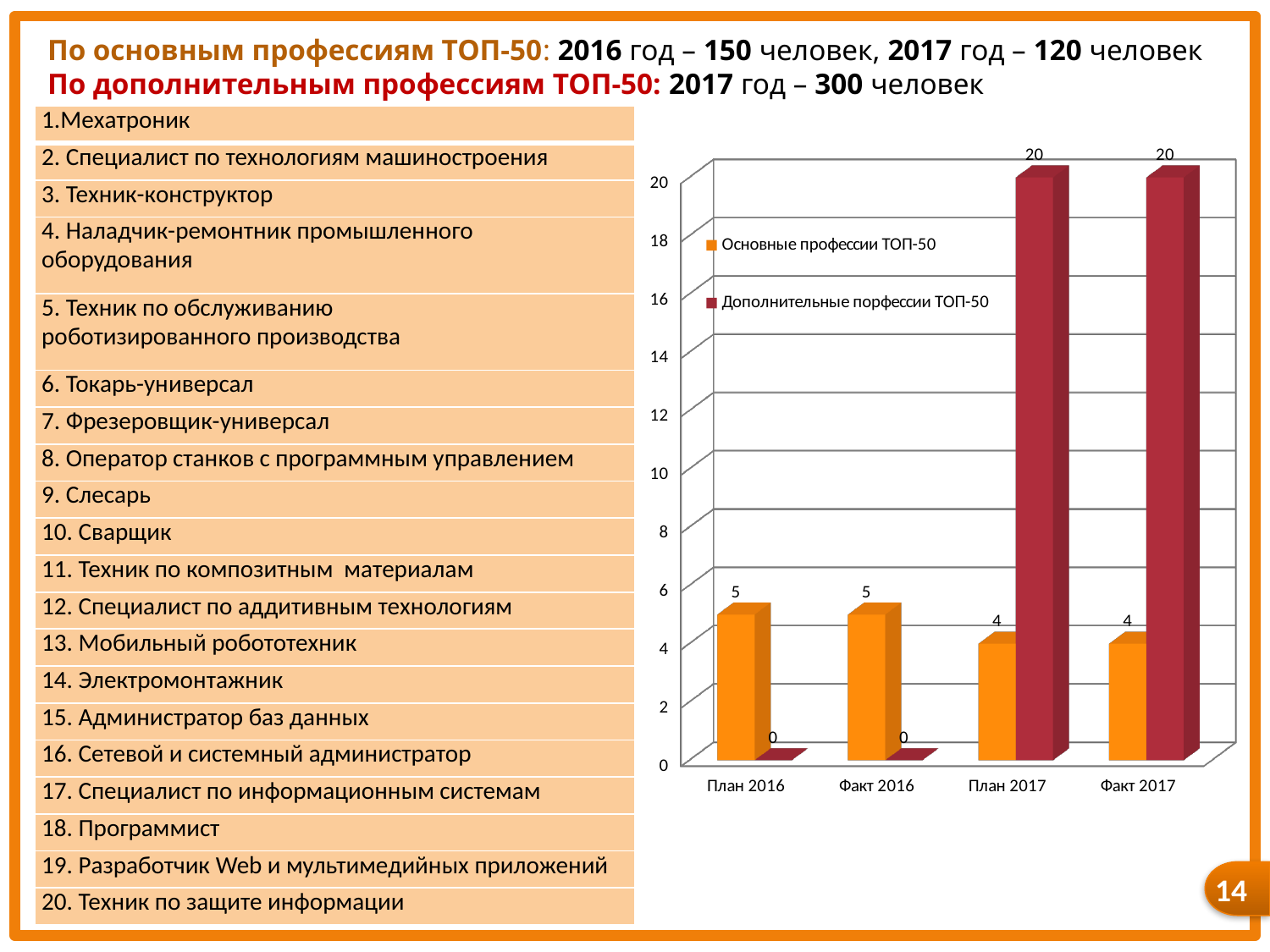
How many series does the chart legend list? 2 What is the difference between Дополнительные порфессии ТОП-50 and Основные профессии ТОП-50 for План 2017? 16 Which series has the larger value for Факт 2016? Основные профессии ТОП-50 Does the value of Основные профессии ТОП-50 fall or rise from Факт 2016 to План 2017? fall How many categories are shown on the x axis of the chart? 4 What is the value of Дополнительные порфессии ТОП-50 for Факт 2016? 0 What is the value of Основные профессии ТОП-50 for План 2016? 5 What type of chart is shown on the slide? bar chart What colour are the bars for Основные профессии ТОП-50? orange What is the value of Дополнительные порфессии ТОП-50 for Факт 2017? 20 Which category has the highest value for Дополнительные порфессии ТОП-50 in the chart, План 2016 or План 2017? План 2017 What is the value of Основные профессии ТОП-50 for Факт 2017? 4